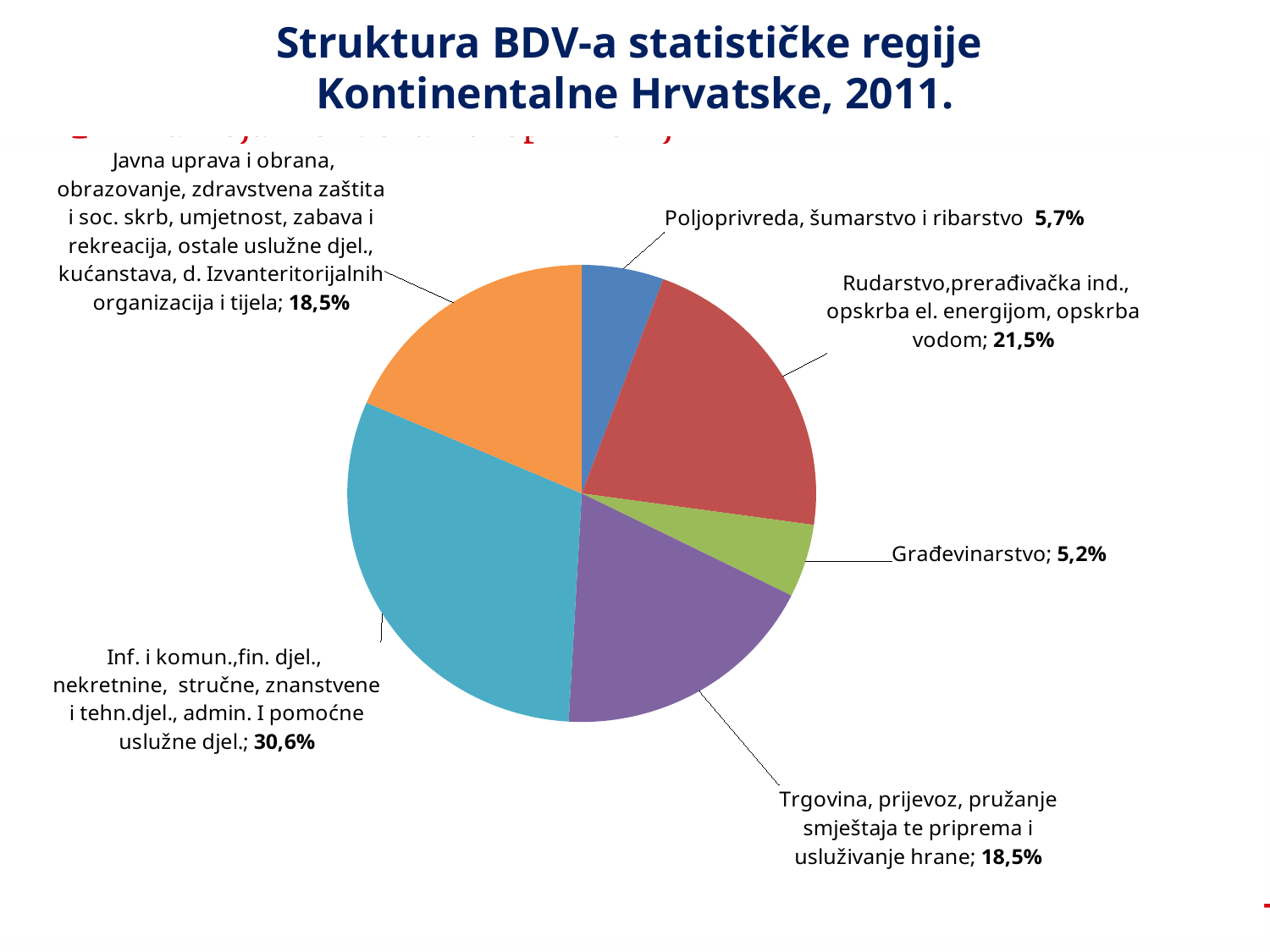
How many categories are shown in the pie chart? 6 What is the value for Rudarstvo, prerađivačka ind., opskrba el. energijom, opskrba vodom? 21,5% What is the title of the chart on the slide? Struktura BDV-a statističke regije Kontinentalne Hrvatske, 2011. Which category has the smallest slice of the pie? Građevinarstvo What is the combined share of Trgovina, prijevoz, pružanje smještaja te priprema i usluživanje hrane and Javna uprava i obrana, obrazovanje, zdravstvena zaštita i soc. skrb, umjetnost, zabava i rekreacija, ostale uslužne djel., kućanstava, d. Izvanteritorijalnih organizacija i tijela? 37,0% What share of the pie does Građevinarstvo hold? 5,2% What percentage is shown for Trgovina, prijevoz, pružanje smještaja te priprema i usluživanje hrane? 18,5% What kind of chart is shown on the slide? Pie chart What is the difference between the share of Rudarstvo, prerađivačka ind., opskrba el. energijom, opskrba vodom and the share of Trgovina, prijevoz, pružanje smještaja te priprema i usluživanje hrane? 3,0 percentage points Which is larger: the share of Poljoprivreda, šumarstvo i ribarstvo or the share of Građevinarstvo? Poljoprivreda, šumarstvo i ribarstvo What percentage is shown for Poljoprivreda, šumarstvo i ribarstvo? 5,7% Which category has the largest slice of the pie? Inf. i komun., fin. djel., nekretnine, stručne, znanstvene i tehn. djel., admin. i pomoćne uslužne djel.